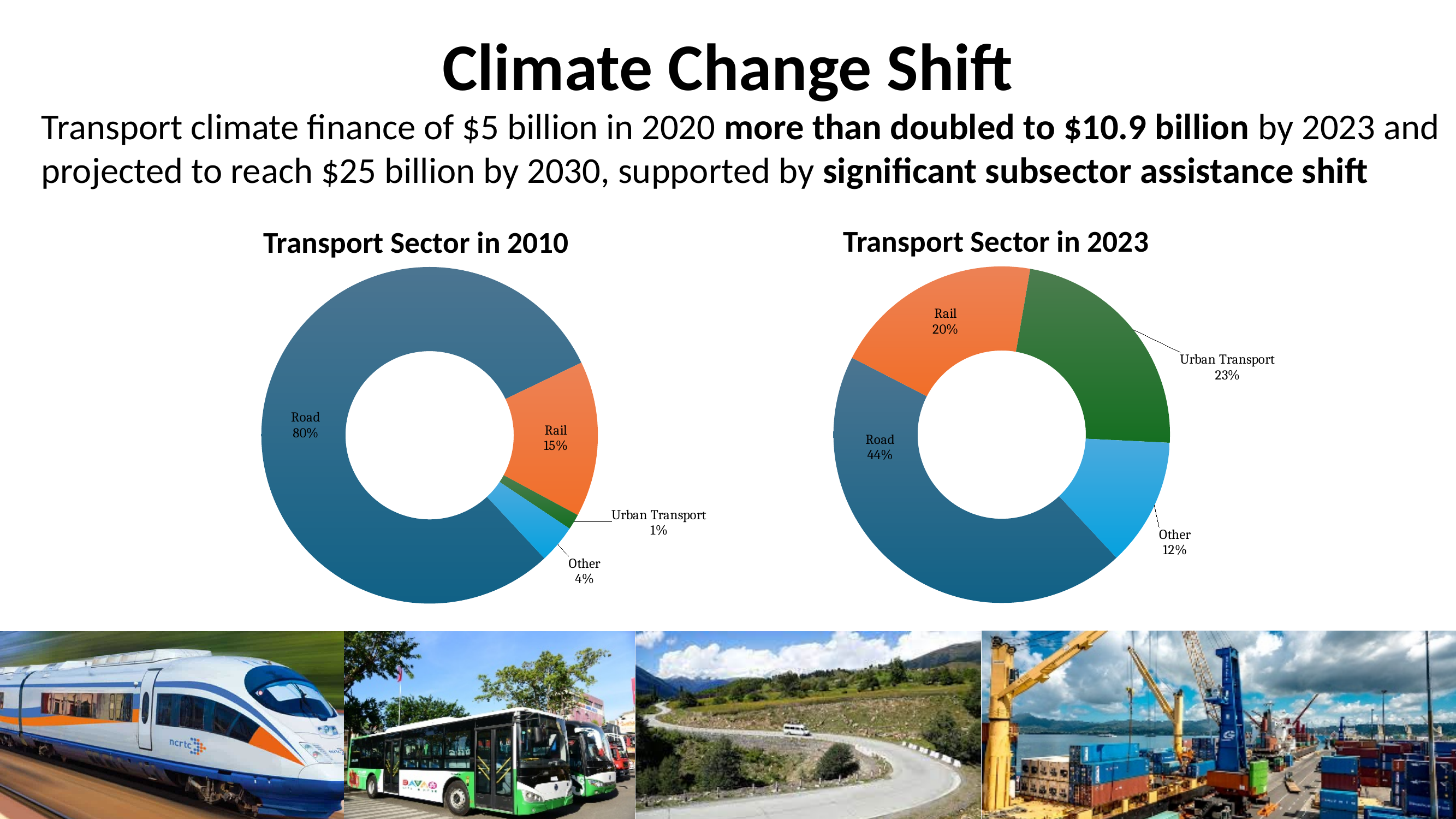
In the 'Transport Sector in 2023' chart, what share does Urban Transport have? 23% What kind of chart is 'Transport Sector in 2023'? Doughnut chart In the 'Transport Sector in 2023' chart, which is larger, Urban Transport or Other? Urban Transport In the 'Transport Sector in 2010' chart, what share does Urban Transport have? 1% In the 'Transport Sector in 2023' chart, what share does Rail have? 20% In the 'Transport Sector in 2010' chart, which category has the largest share? Road In the 'Transport Sector in 2010' chart, what share does Road have? 80% What is the title of the chart on the left side of the slide? Transport Sector in 2010 In the 'Transport Sector in 2010' chart, which category has the smallest share? Urban Transport How many categories are shown in the 'Transport Sector in 2010' chart? 4 In the 'Transport Sector in 2023' chart, which category has the smallest share? Other In the 'Transport Sector in 2023' chart, what is the difference between the Road share and the Rail share? 24%